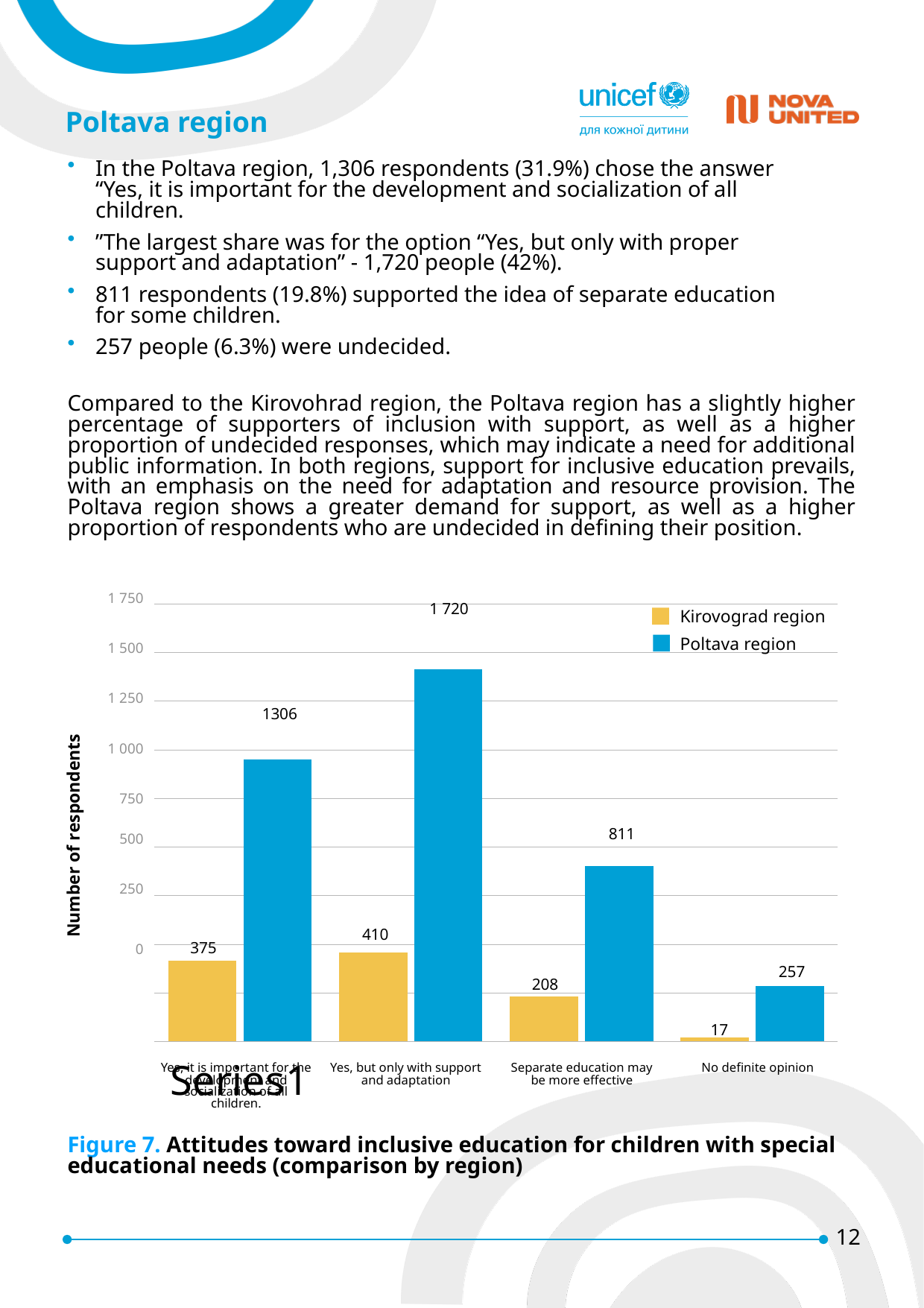
What is the difference between the Poltava region and the Kirovograd region for "No definite opinion"? 240 What is the value for the Poltava region for "Separate education may be more effective"? 811 How many answer categories are shown on the x axis of the chart? 4 How many series does the legend of the chart list? 2 What kind of chart is shown in Figure 7? bar chart What is the label of the y axis of the chart? Number of respondents What is the value for the Kirovograd region for "No definite opinion"? 17 What is the value for the Kirovograd region for "Separate education may be more effective"? 208 What is the value for the Poltava region for "Yes, but only with support and adaptation"? 1 720 Which category has the highest value for the Poltava region? Yes, but only with support and adaptation Which region has the larger value for "Yes, it is important for the development and socialization of all children"? Poltava region Which category has the lowest value for the Kirovograd region? No definite opinion